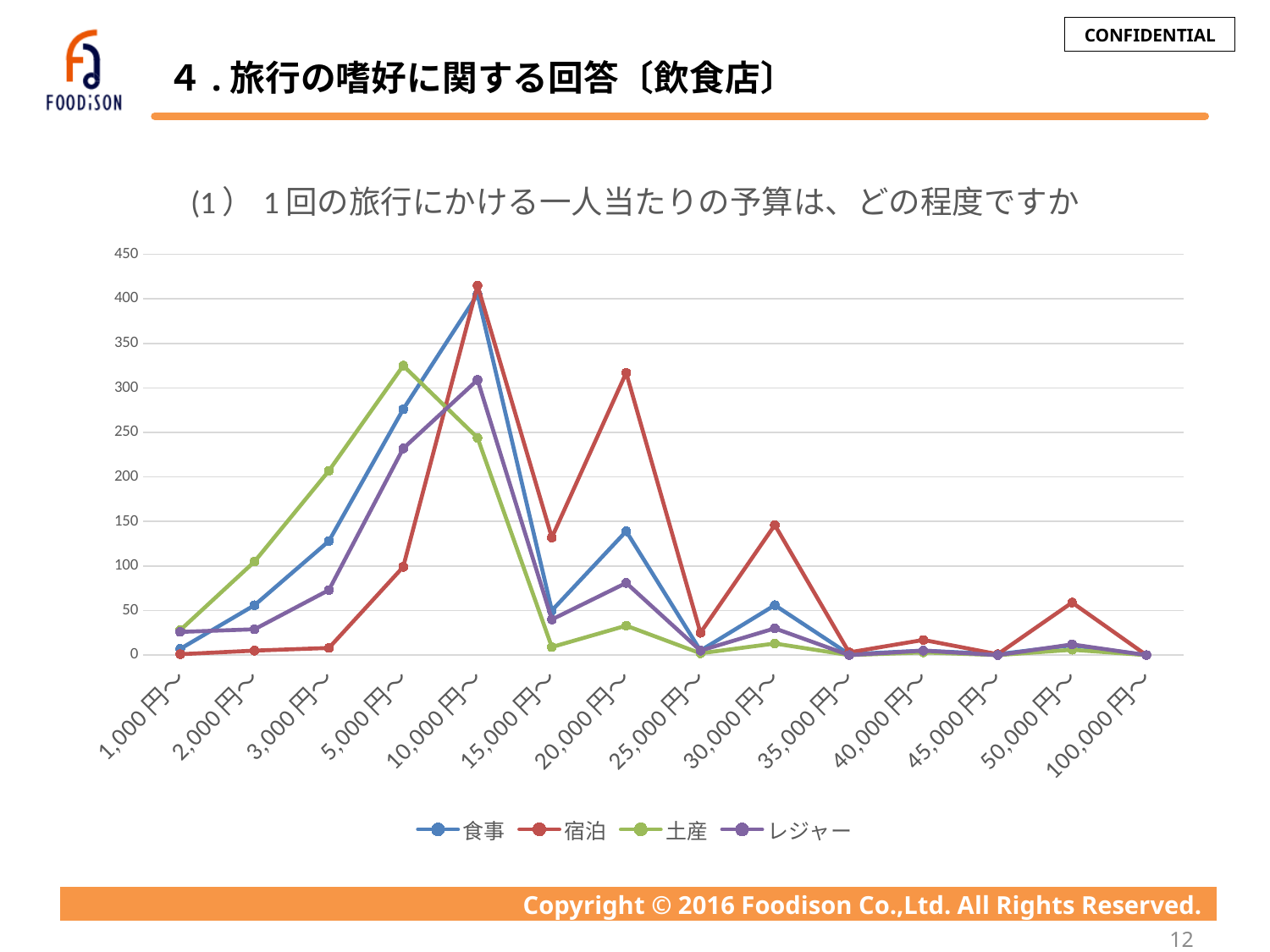
Is the value for レジャー at 10,000円～ greater or less than 250? greater Is the value for 宿泊 at 5,000円～ greater or less than 150? less At 2,000円～, which is larger: 土産 or 食事? 土産 Is the value for 土産 at 5,000円～ greater or less than 300? greater How many series does the legend list? 4 At which budget category does the 宿泊 series reach its highest value? 10,000円～ Which series are listed in the legend? 食事, 宿泊, 土産, レジャー Which series has the highest value at 20,000円～? 宿泊 What kind of chart is shown on the slide? line chart How many budget categories are shown along the x axis? 14 Which series has the highest value at 5,000円～? 土産